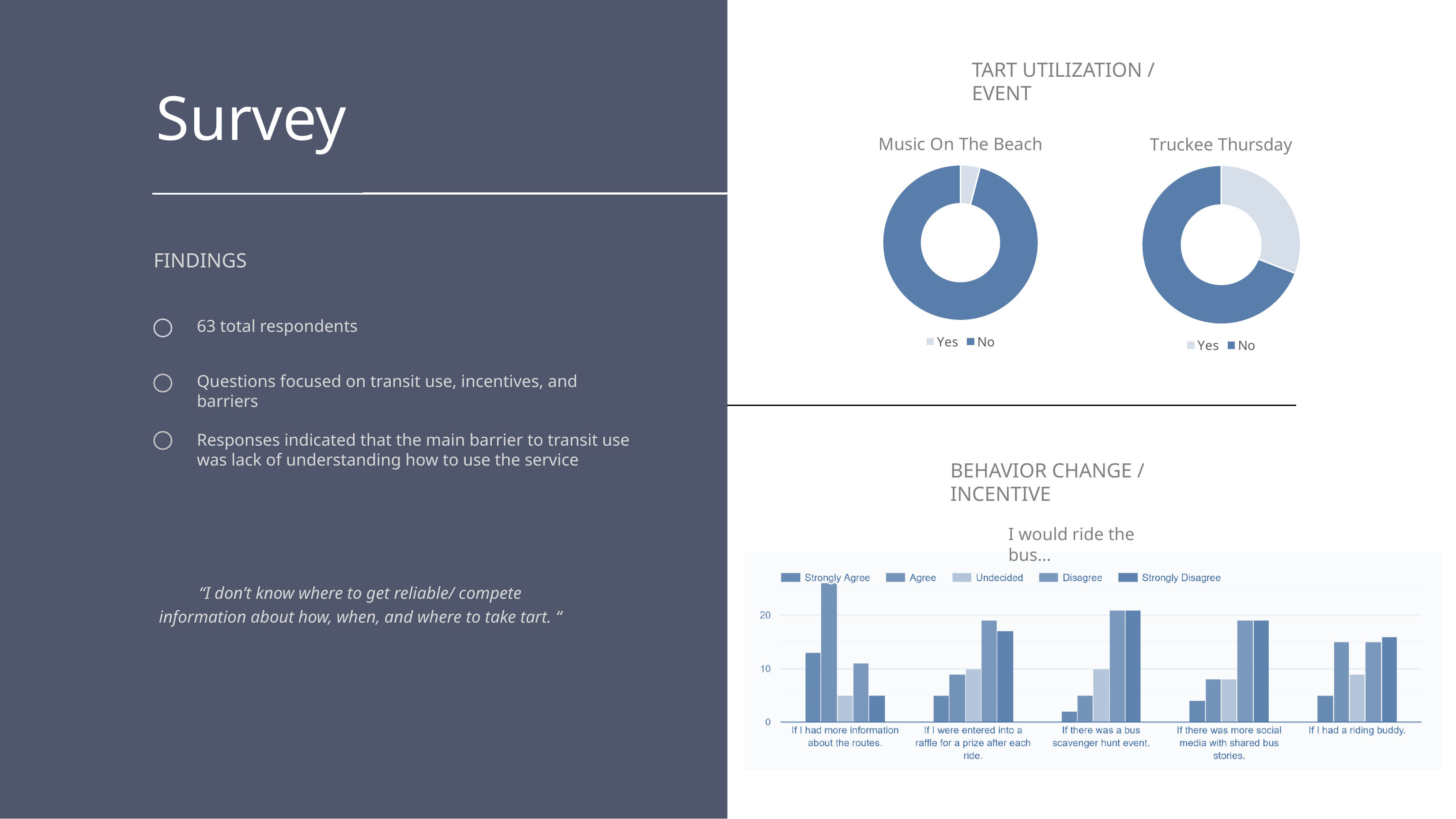
In the Truckee Thursday chart, which slice is larger, Yes or No? No In the 'I would ride the bus...' chart, is the Agree value for 'If I had more information about the routes' greater or less than 20? greater In the 'I would ride the bus...' chart, for 'If I had more information about the routes', which is larger, Agree or Strongly Disagree? Agree How many entries does the legend of the Truckee Thursday chart list? 2 What kind of chart is the 'I would ride the bus...' chart? Bar chart In the Music On The Beach chart, which slice is larger, Yes or No? No How many series does the legend of the 'I would ride the bus...' chart list? 5 In the 'I would ride the bus...' chart, is the Strongly Agree value for 'If there was a bus scavenger hunt event' greater or less than 10? less In the 'I would ride the bus...' chart, which category has the highest Agree value? If I had more information about the routes. What kind of chart is the Music On The Beach chart? Doughnut chart How many categories are shown on the x axis of the 'I would ride the bus...' chart? 5 What are the legend entries of the 'I would ride the bus...' chart? Strongly Agree, Agree, Undecided, Disagree, Strongly Disagree